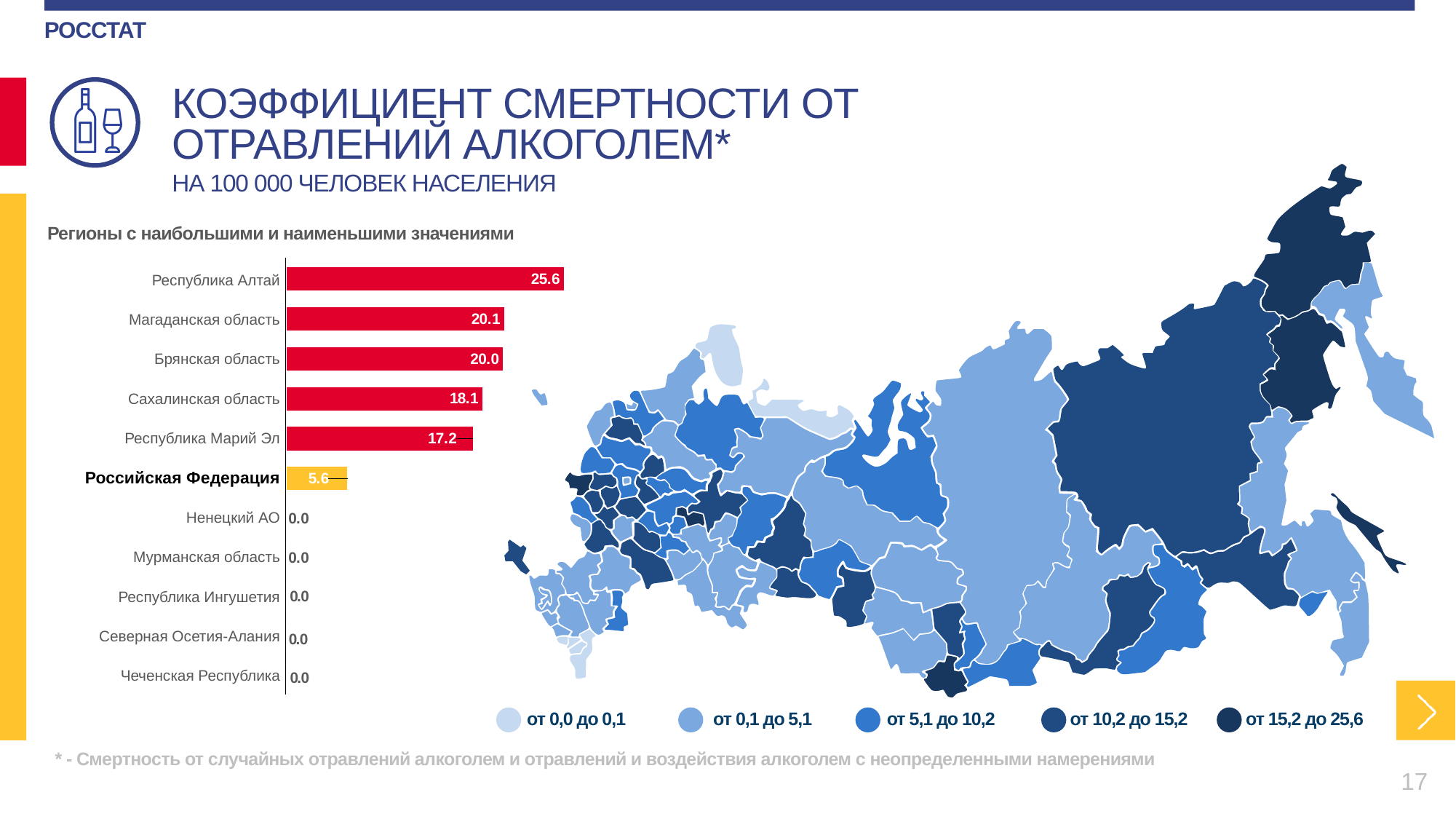
What value is shown for Чеченская Республика in the bar chart? 0.0 What is the value for Сахалинская область in the bar chart? 18.1 What is the value for Республика Алтай in the bar chart? 25.6 Which is larger in the bar chart: the value for Брянская область or Сахалинская область? Брянская область What is the difference between the values for Республика Марий Эл and Российская Федерация? 11.6 How many regions (categories) are shown in the bar chart? 11 What is the difference between the values for Республика Алтай and Магаданская область? 5.5 How many value ranges does the map legend list? 5 What is the value for Российская Федерация in the bar chart? 5.6 What is the value for Магаданская область in the bar chart? 20.1 What type of chart is used to show the regions with the highest and lowest values? Bar chart Which region has the highest value in the bar chart? Республика Алтай